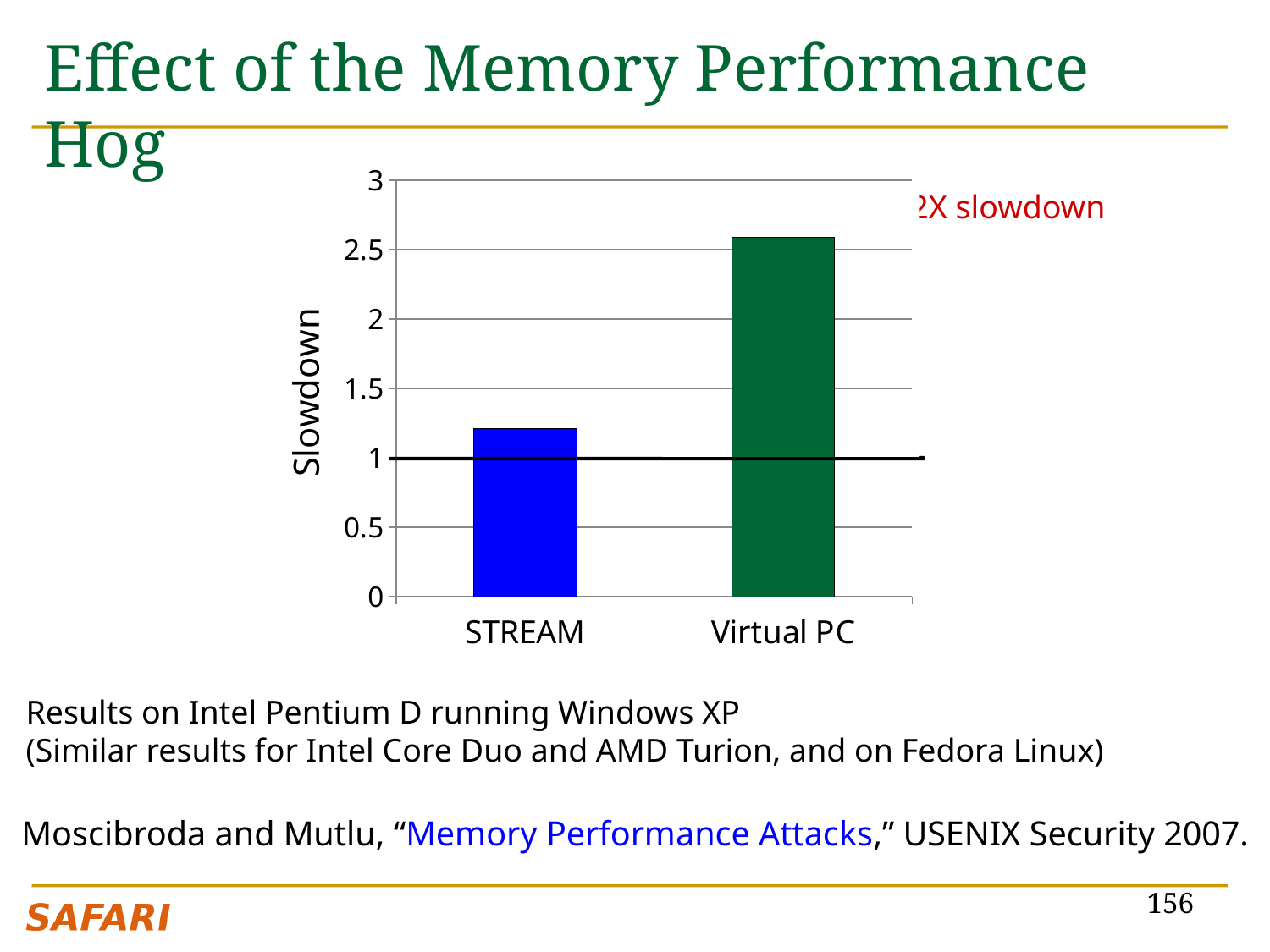
Which category has the highest slowdown? Virtual PC Which has a larger slowdown, STREAM or Virtual PC? Virtual PC How many categories are plotted on the x axis? 2 Is the slowdown for STREAM greater or less than 1.5? less What is the label of the y axis? Slowdown Is the slowdown for Virtual PC greater or less than 2.5? greater What kind of chart is shown on the slide? bar chart Is the slowdown for Virtual PC greater or less than 2? greater What colour is the bar for Virtual PC? green Which category has the lowest slowdown? STREAM